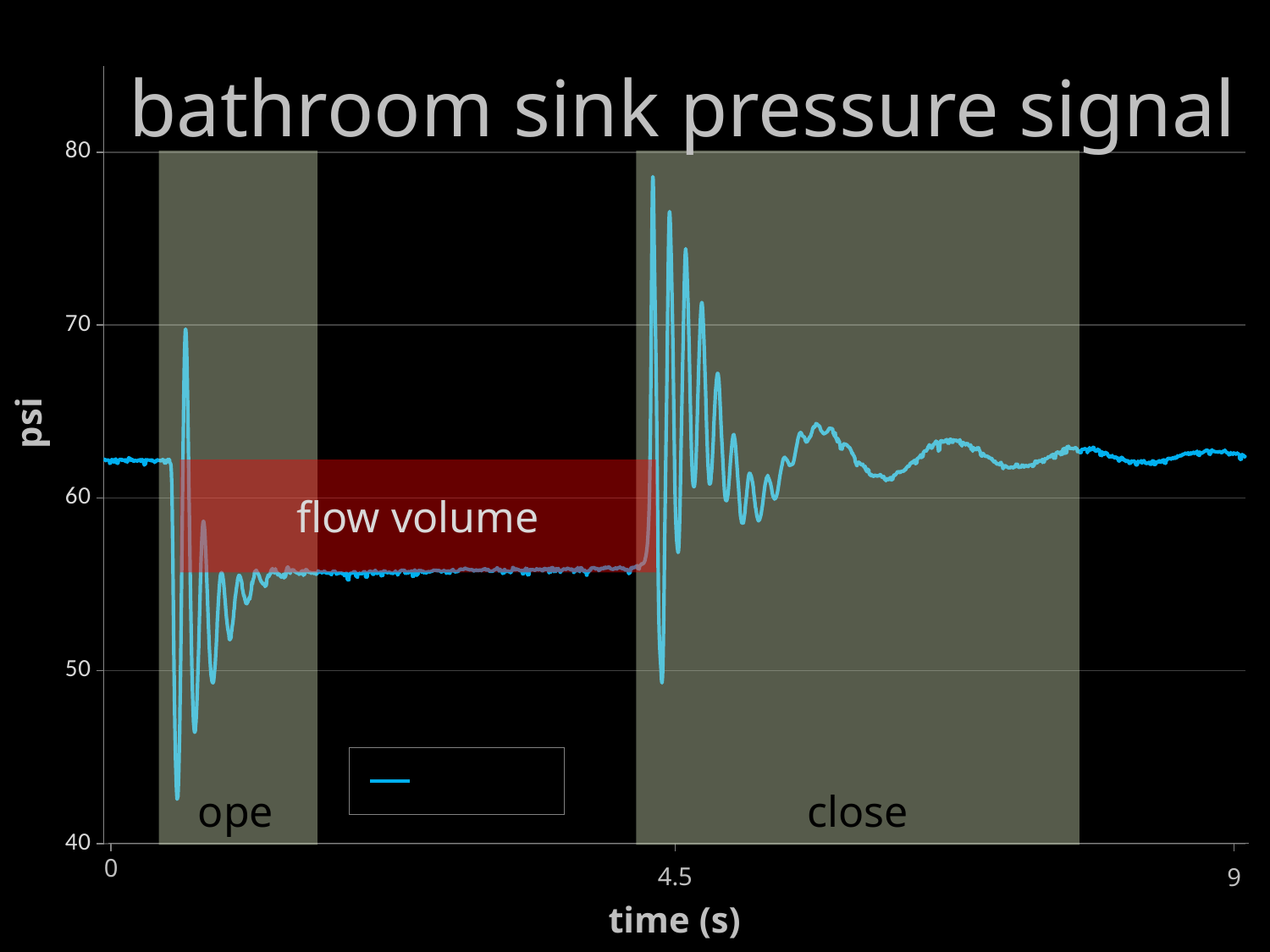
Is the lowest pressure dip in the 'ope' region greater or less than 50 psi? less Is the highest pressure peak in the 'close' region greater or less than 70 psi? greater Which shaded region contains the lower pressure dip, 'ope' or 'close'? ope What is the maximum value shown on the y axis? 80 Which shaded region contains the higher pressure peak, 'ope' or 'close'? close What is the label of the y axis? psi What is the label of the x axis? time (s) What kind of chart is shown on the slide? line chart Is the steady pressure level during the 'flow volume' period greater or less than 60 psi? less How many series does the legend list? 1